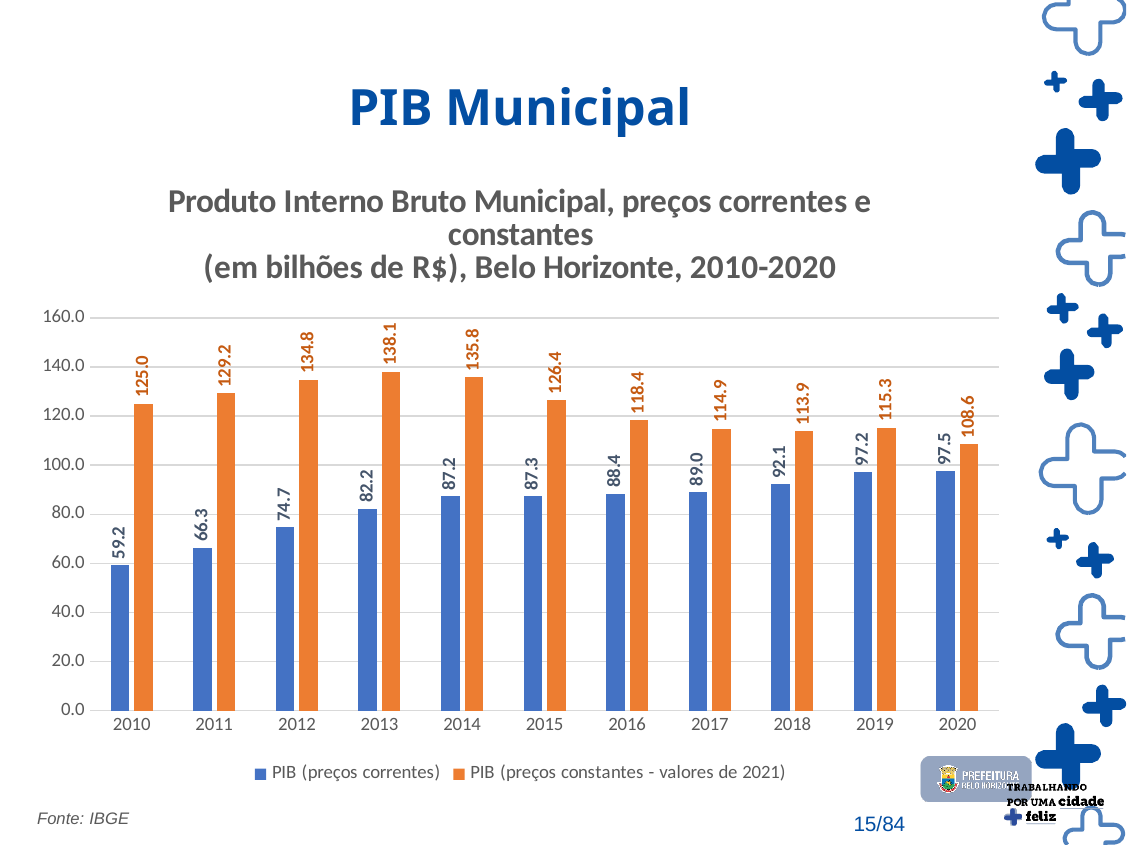
In which year is PIB (preços constantes - valores de 2021) highest? 2013 What is the value of PIB (preços constantes - valores de 2021) for 2013? 138.1 In which year is PIB (preços correntes) lowest? 2010 Which is larger in 2020: PIB (preços correntes) or PIB (preços constantes - valores de 2021)? PIB (preços constantes - valores de 2021) How many years are shown on the x axis? 11 How many series does the legend list? 2 What is the difference between PIB (preços constantes - valores de 2021) and PIB (preços correntes) in 2010? 65.8 Does PIB (preços correntes) rise or fall from 2010 to 2020? Rise What type of chart is shown on the slide? Bar chart What is the value of PIB (preços correntes) for 2010? 59.2 What is the source cited below the chart? IBGE What is the value of PIB (preços correntes) for 2020? 97.5